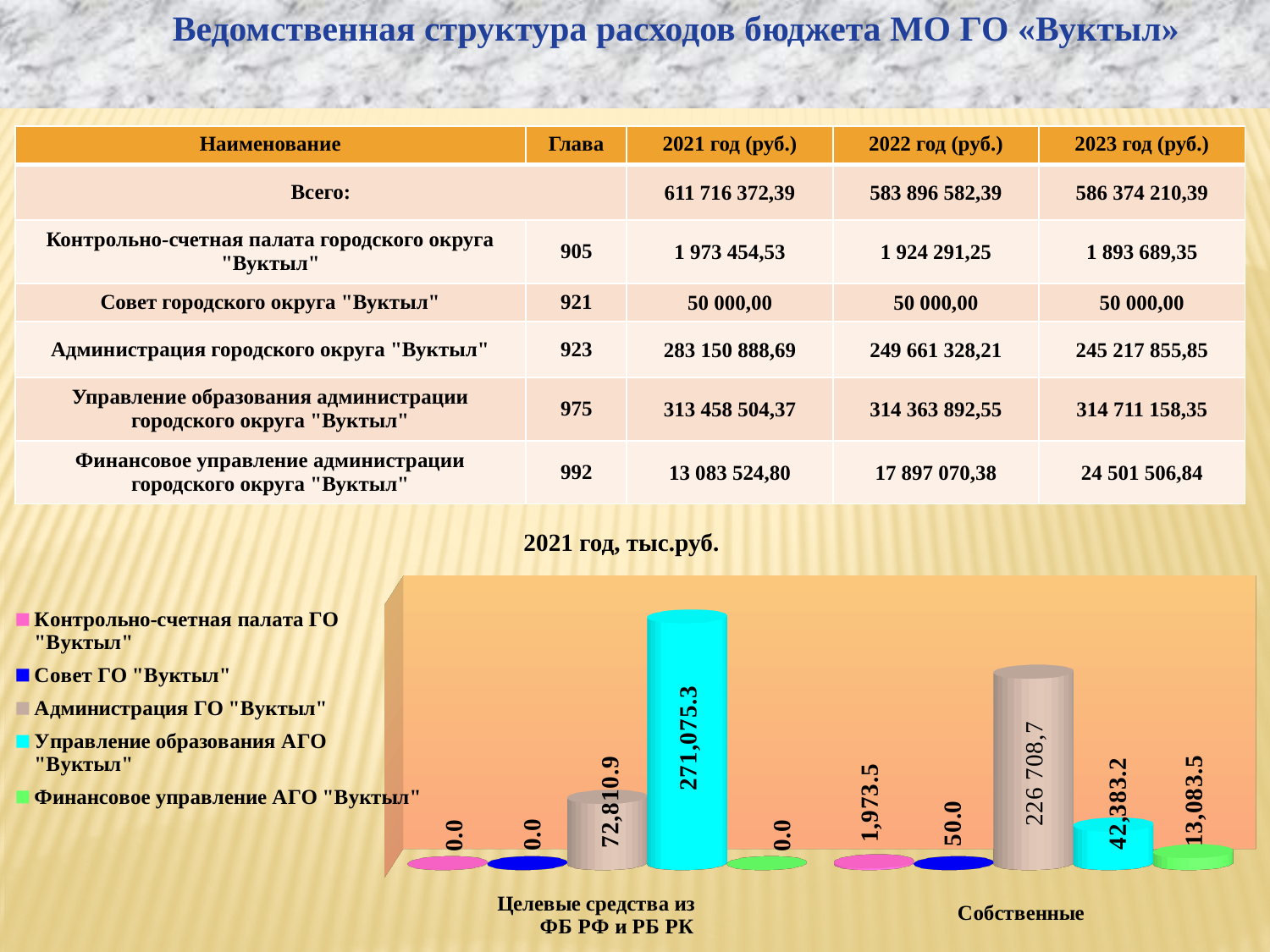
Which is larger for Управление образования АГО "Вуктыл": the value in Целевые средства из ФБ РФ и РБ РК or in Собственные? Целевые средства из ФБ РФ и РБ РК What kind of chart is shown on the slide? bar chart What is the value for Совет ГО "Вуктыл" in the category Целевые средства из ФБ РФ и РБ РК? 0.0 What is the title of the chart? 2021 год, тыс.руб. What is the value for Управление образования АГО "Вуктыл" in the category Целевые средства из ФБ РФ и РБ РК? 271,075.3 What is the value for Финансовое управление АГО "Вуктыл" in the category Собственные? 13,083.5 What is the value for Контрольно-счетная палата ГО "Вуктыл" in the category Собственные? 1,973.5 Which series has the highest value in the category Целевые средства из ФБ РФ и РБ РК? Управление образования АГО "Вуктыл" How many series does the chart legend list? 5 What is the value for Администрация ГО "Вуктыл" in the category Собственные? 226 708,7 How many categories are shown on the x axis of the chart? 2 Which series has the highest value in the category Собственные? Администрация ГО "Вуктыл"